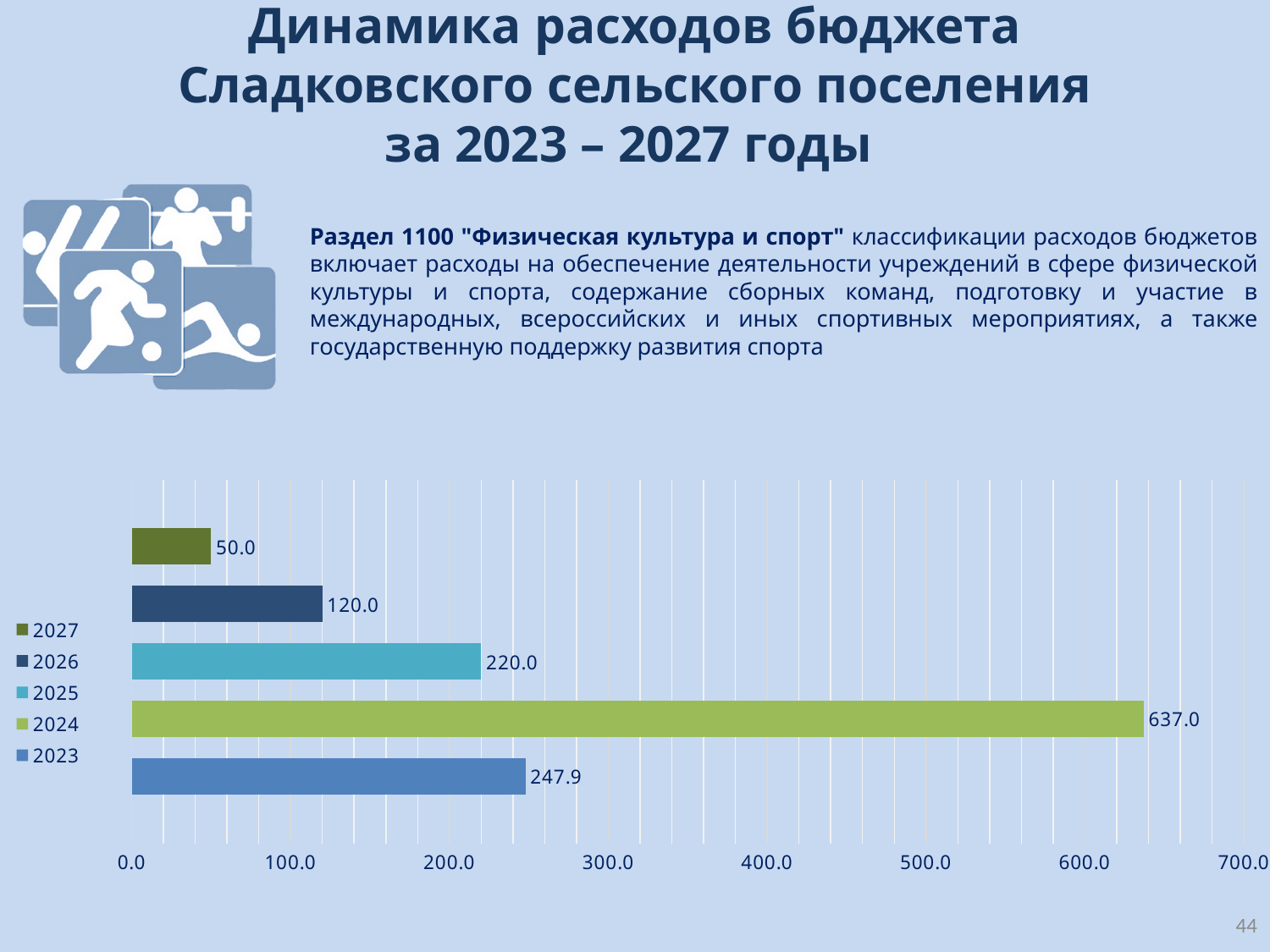
What is the value shown for 2025? 220.0 How many entries does the legend list? 5 What kind of chart is shown on the slide? bar chart Which year has the highest value? 2024 How many bars are plotted on the chart? 5 Which is larger, the value for 2023 or the value for 2025? 2023 What is the difference between the values for 2025 and 2026? 100.0 Which year has the lowest value? 2027 What is the value shown for 2027? 50.0 What is the difference between the values for 2024 and 2023? 389.1 What is the value shown for 2024? 637.0 What is the value shown for 2023? 247.9